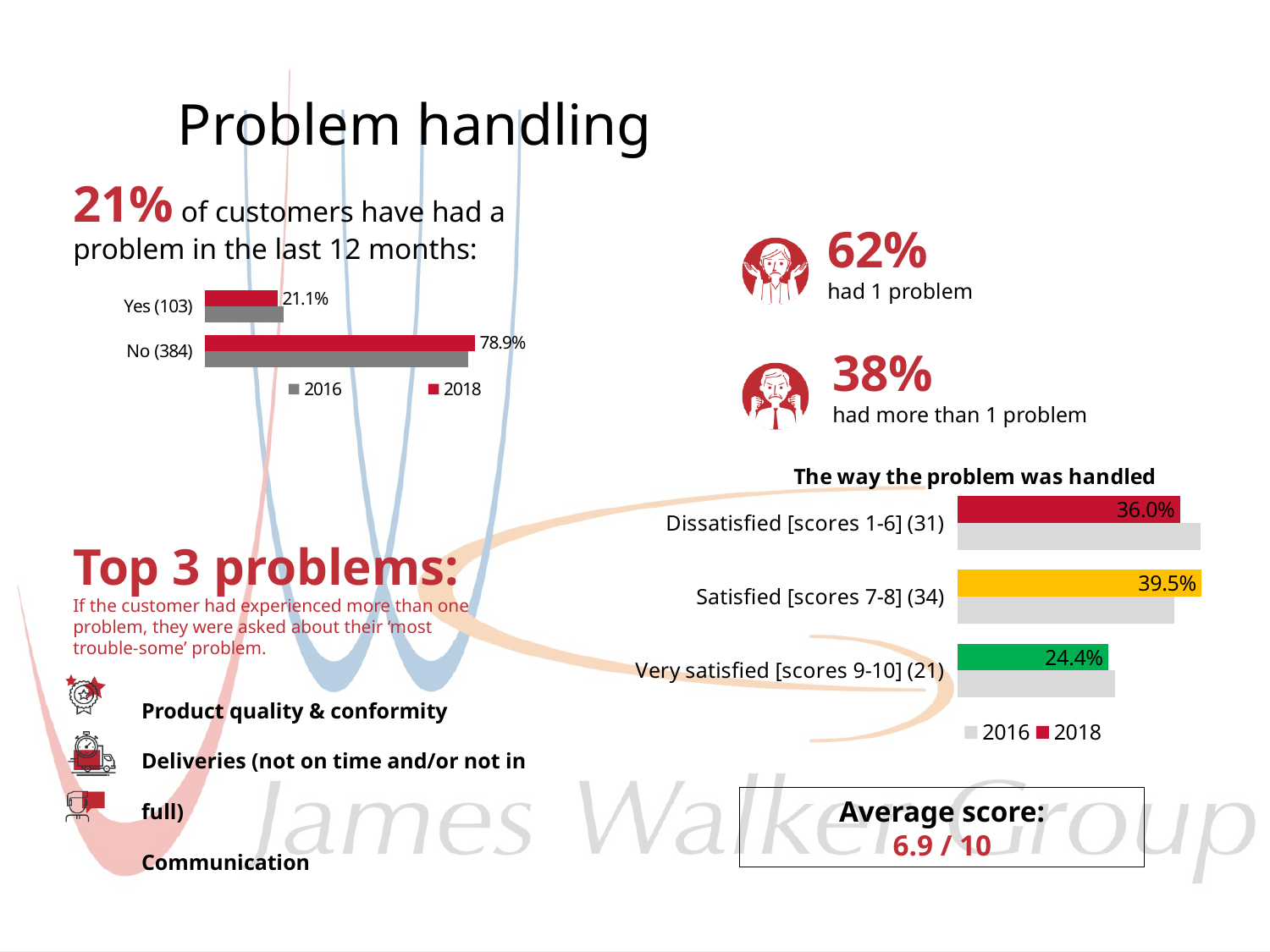
In the chart on the left about customers having had a problem in the last 12 months, what is the difference between the 2018 values for No (384) and Yes (103)? 57.8% In the chart titled 'The way the problem was handled', what is the 2018 value for Very satisfied [scores 9-10] (21)? 24.4% In the chart on the left about customers having had a problem in the last 12 months, what is the 2018 value for No (384)? 78.9% In the chart titled 'The way the problem was handled', which category has the lowest 2018 value? Very satisfied [scores 9-10] (21) In the chart titled 'The way the problem was handled', what is the difference between the 2018 values for Satisfied and Very satisfied? 15.1% In the chart titled 'The way the problem was handled', which category has the highest 2018 value? Satisfied [scores 7-8] (34) In the chart titled 'The way the problem was handled', what is the 2018 value for Dissatisfied [scores 1-6] (31)? 36.0% In the chart titled 'The way the problem was handled', what is the 2018 value for Satisfied [scores 7-8] (34)? 39.5% In the chart titled 'The way the problem was handled', how many series does the legend list? 2 In the chart on the left about customers having had a problem in the last 12 months, how many categories are shown? 2 What kind of chart is the chart titled 'The way the problem was handled'? Bar chart In the chart on the left about customers having had a problem in the last 12 months, what is the 2018 value for Yes (103)? 21.1%